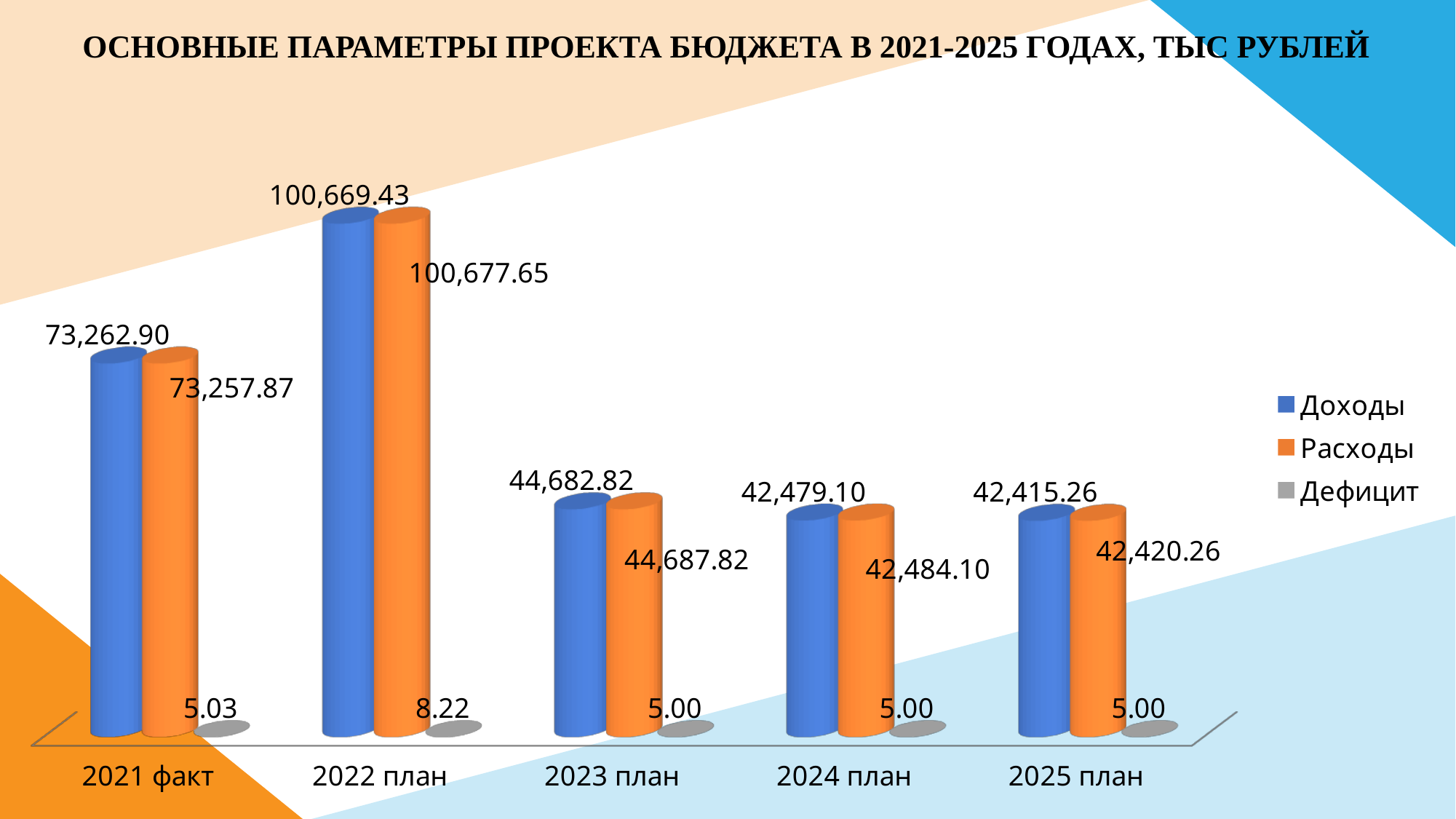
What kind of chart is shown on the slide? Bar chart In which category is Доходы the highest? 2022 план What is the difference between Расходы and Доходы for 2022 план? 8.22 In which category is Дефицит the highest? 2022 план How many categories are shown on the x axis? 5 What is the difference between Доходы for 2022 план and Доходы for 2021 факт? 27,406.53 What is the value of Расходы for 2021 факт? 73,257.87 What is the value of Доходы for 2022 план? 100,669.43 What is the value of Расходы for 2025 план? 42,420.26 What is the value of Дефицит for 2022 план? 8.22 How many series does the legend list? 3 Which is larger: Расходы for 2021 факт or Расходы for 2023 план? Расходы for 2021 факт